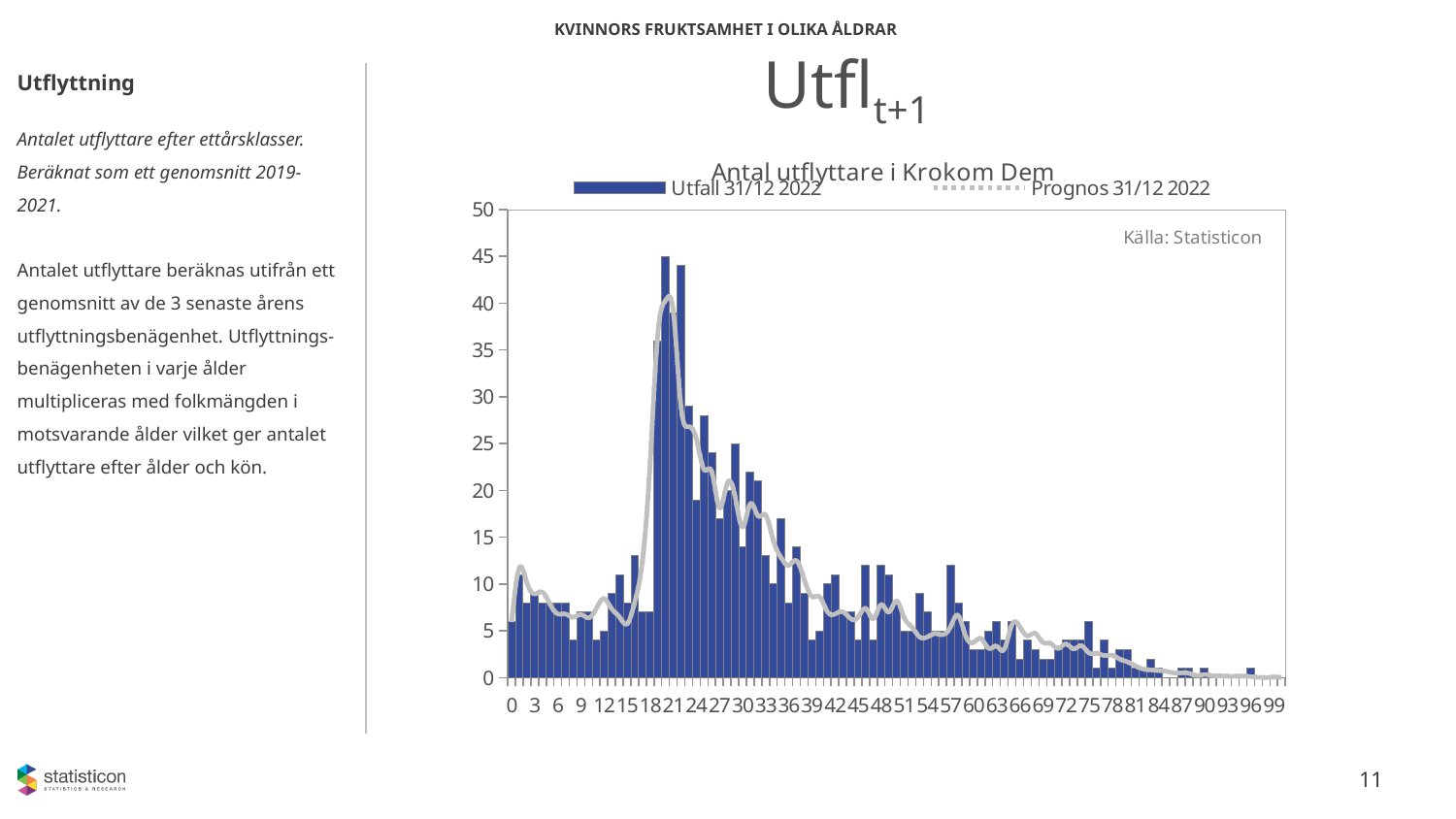
Which has the larger Utfall value, age 3 or age 90? Age 3 How many series does the legend of the chart list? 2 What kind of chart is 'Antal utflyttare i Krokom Dem'? Bar chart with a line overlay What source is cited on the chart? Källa: Statisticon Is the Utfall value for age 3 greater or less than 5? greater Which has the larger Utfall value, age 21 or age 60? Age 21 What are the two legend entries of the chart? Utfall 31/12 2022 and Prognos 31/12 2022 Is the value of the tallest bar in the chart greater or less than 40? greater Do the Utfall values generally rise or fall along the x axis from age 21 to age 99? Fall Is the Utfall value for age 60 greater or less than 5? less